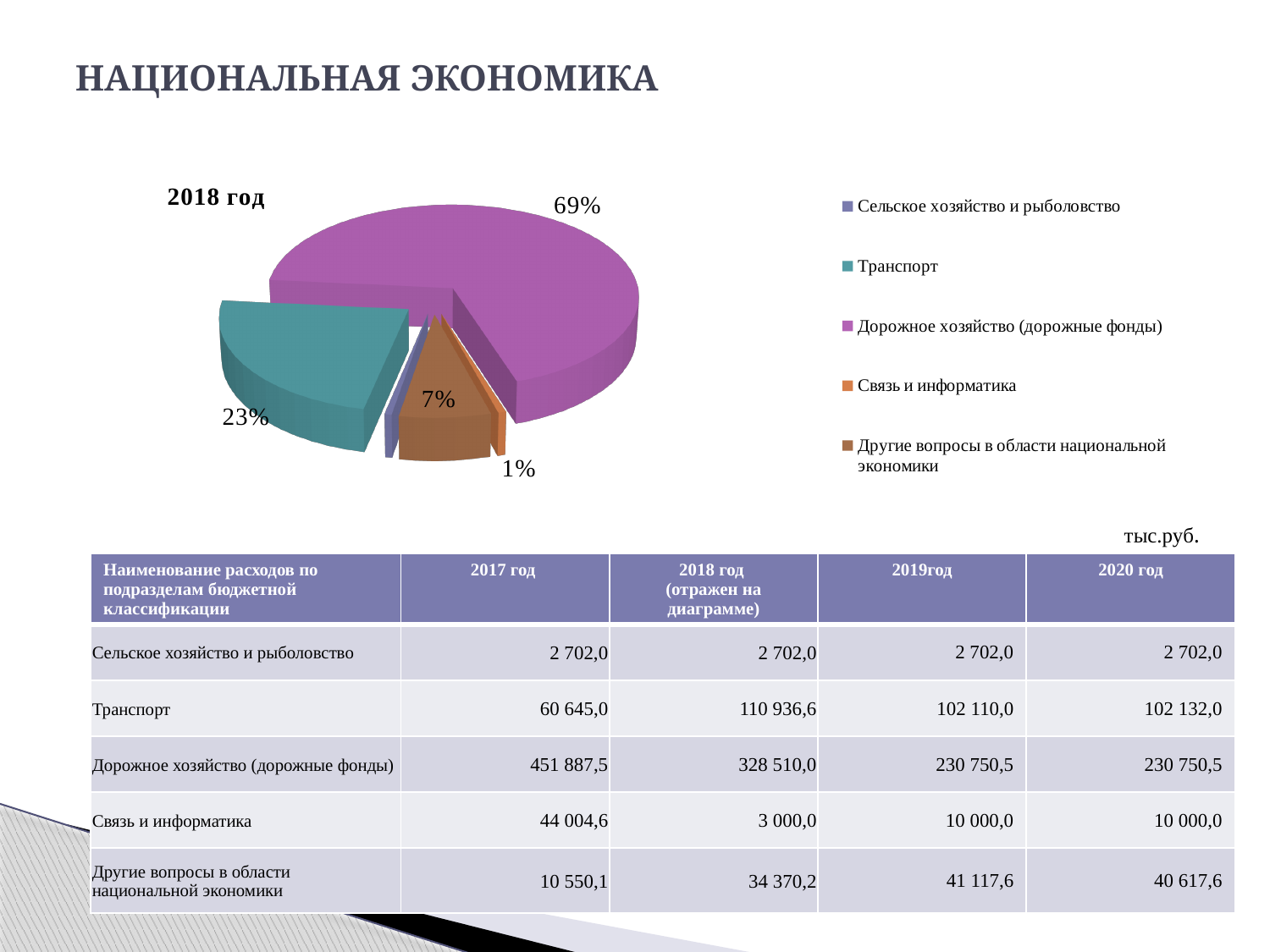
Which category has the largest slice in the 2018 pie chart? Дорожное хозяйство (дорожные фонды) How many categories does the legend of the pie chart list? 5 What share of the 2018 pie chart is Другие вопросы в области национальной экономики? 7% What colour is the Дорожное хозяйство (дорожные фонды) slice in the pie chart? Purple What share of the 2018 pie chart is Дорожное хозяйство (дорожные фонды)? 69% What share of the 2018 pie chart is Связь и информатика? 1% What is the title of the pie chart? 2018 год In the 2018 pie chart, how many percentage points larger is the Дорожное хозяйство slice than the Транспорт slice? 46% In the 2018 pie chart, which slice is larger: Транспорт or Другие вопросы в области национальной экономики? Транспорт What type of chart is shown on the slide? Pie chart What share of the 2018 pie chart is Транспорт? 23%